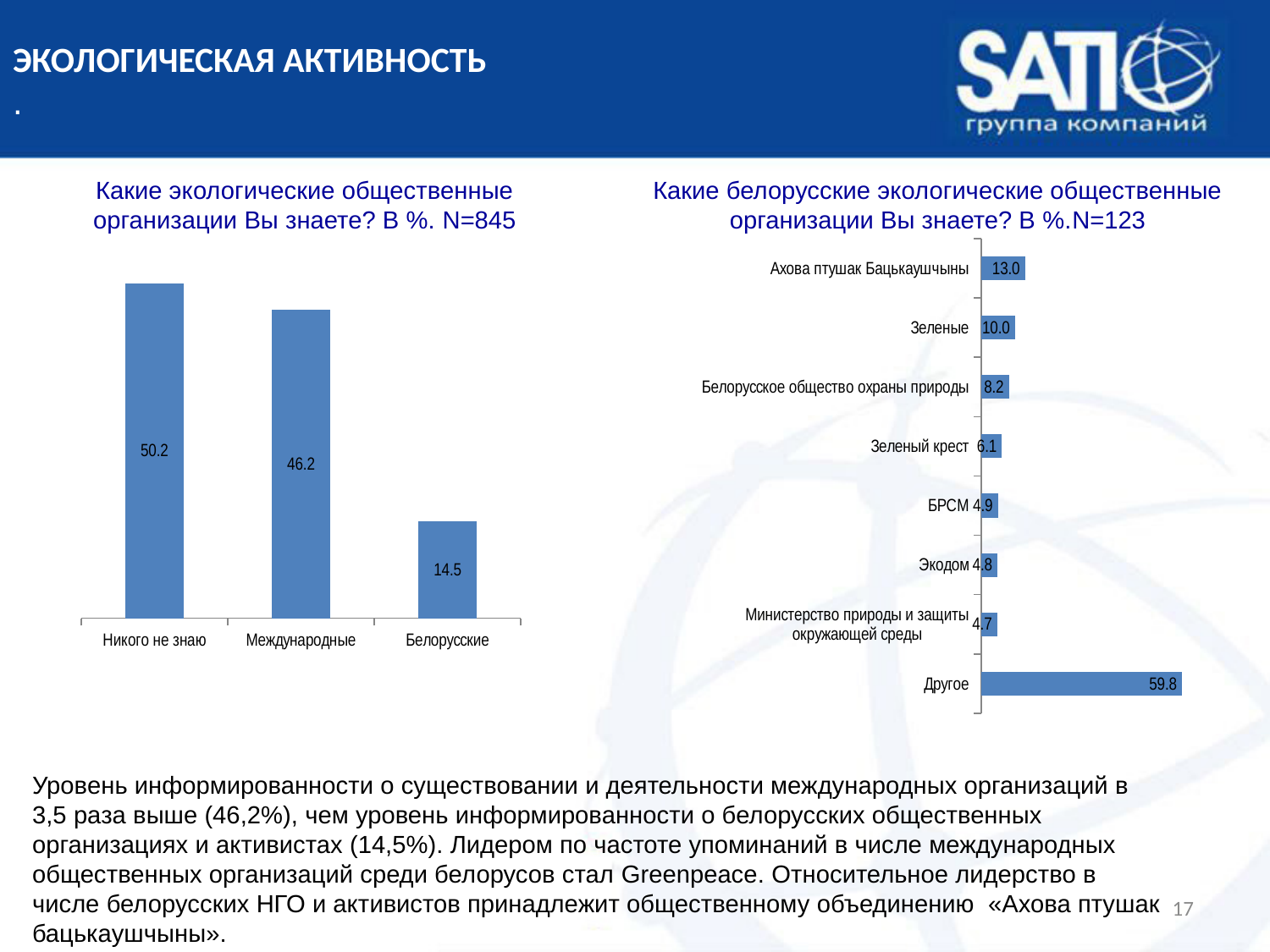
What kind of chart is the left chart (Какие экологические общественные организации Вы знаете?)? Bar chart In the right chart (Какие белорусские экологические общественные организации Вы знаете?), what is the value for Зеленые? 10.0 In the left chart (Какие экологические общественные организации Вы знаете?), what is the value for Никого не знаю? 50.2 In the left chart (Какие экологические общественные организации Вы знаете?), which category has the lowest value? Белорусские In the right chart (Какие белорусские экологические общественные организации Вы знаете?), what is the value for Другое? 59.8 In the right chart (Какие белорусские экологические общественные организации Вы знаете?), what is the difference between Ахова птушак Бацькаушчыны and Белорусское общество охраны природы? 4.8 In the right chart (Какие белорусские экологические общественные организации Вы знаете?), which is larger: Ахова птушак Бацькаушчыны or Зеленый крест? Ахова птушак Бацькаушчыны In the right chart (Какие белорусские экологические общественные организации Вы знаете?), how many categories are shown? 8 In the left chart (Какие экологические общественные организации Вы знаете?), how many categories are shown? 3 In the right chart (Какие белорусские экологические общественные организации Вы знаете?), which category has the highest value? Другое In the left chart (Какие экологические общественные организации Вы знаете?), what is the difference between Международные and Белорусские? 31.7 In the left chart (Какие экологические общественные организации Вы знаете?), what is the value for Белорусские? 14.5